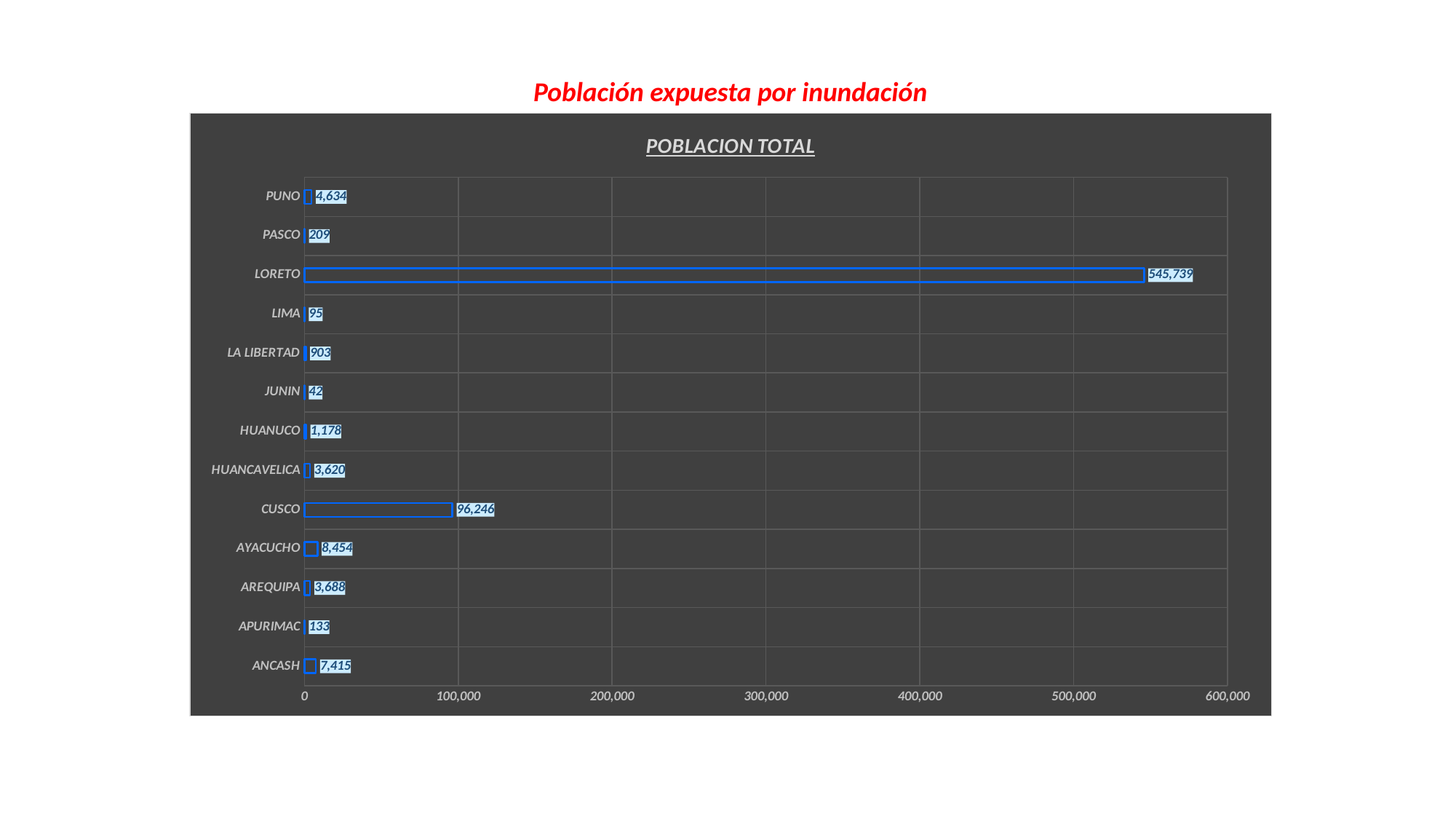
What is the value for JUNIN? 42 How many categories are shown on the chart? 13 Is the value for LORETO greater or less than 500,000? greater What is the value for AYACUCHO? 8,454 What is the value for CUSCO? 96,246 What is the value for LORETO? 545,739 Which category has the highest value? LORETO Which is larger, the value for ANCASH or the value for PUNO? ANCASH Which category has the lowest value? JUNIN What kind of chart is shown? bar chart What is the difference between the values for LORETO and CUSCO? 449,493 What is the title of the chart? POBLACION TOTAL